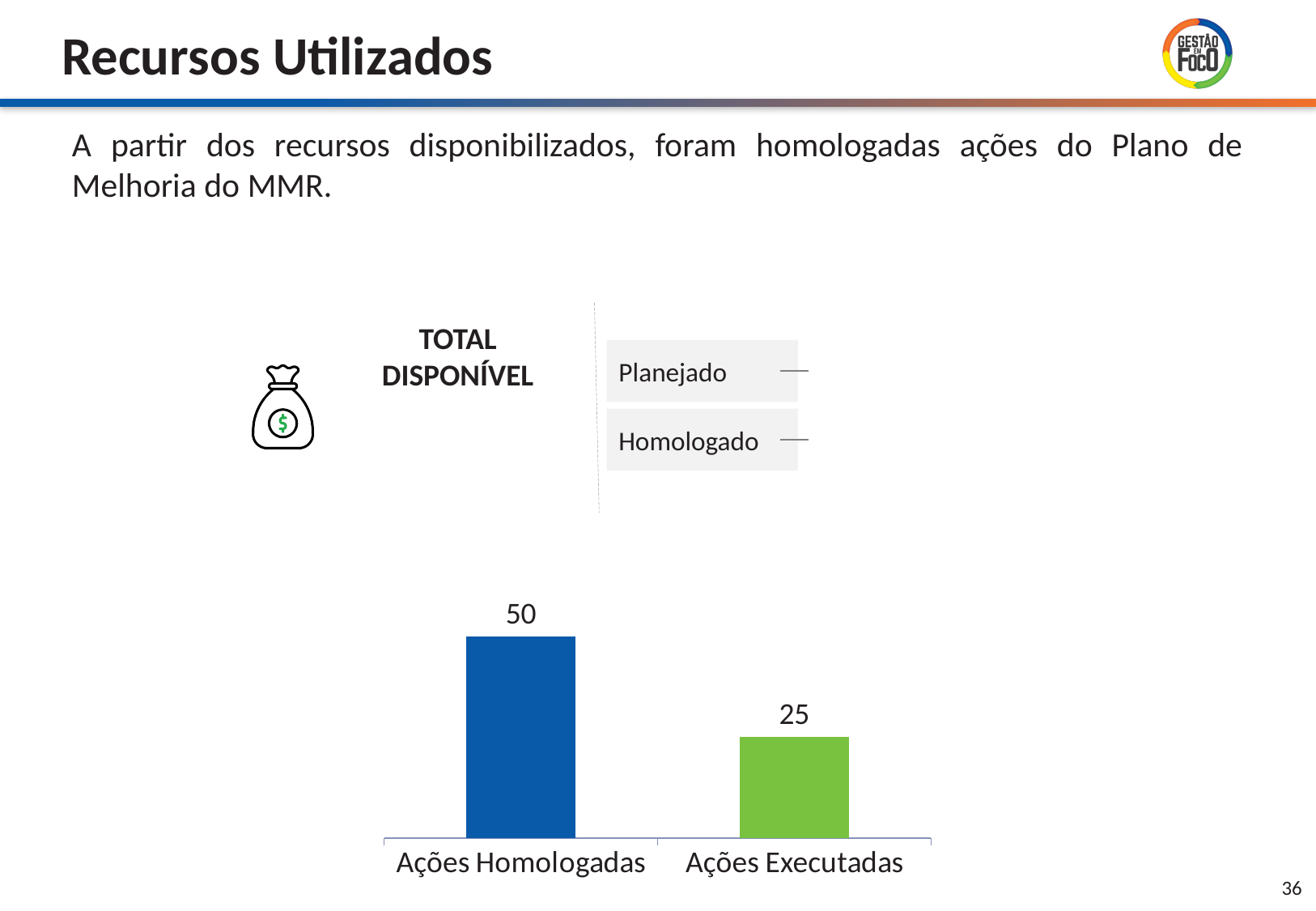
What kind of chart is shown on the slide? Bar chart Which is larger, the value for Ações Homologadas or Ações Executadas? Ações Homologadas How many categories are shown in the chart? 2 Which category has the lowest value? Ações Executadas What colour is the bar for Ações Homologadas? Blue What is the difference between the values for Ações Homologadas and Ações Executadas? 25 What is the value for Ações Executadas? 25 Do the values rise or fall from left to right along the x axis? Fall What colour is the bar for Ações Executadas? Green Which category has the highest value? Ações Homologadas What is the value for Ações Homologadas? 50